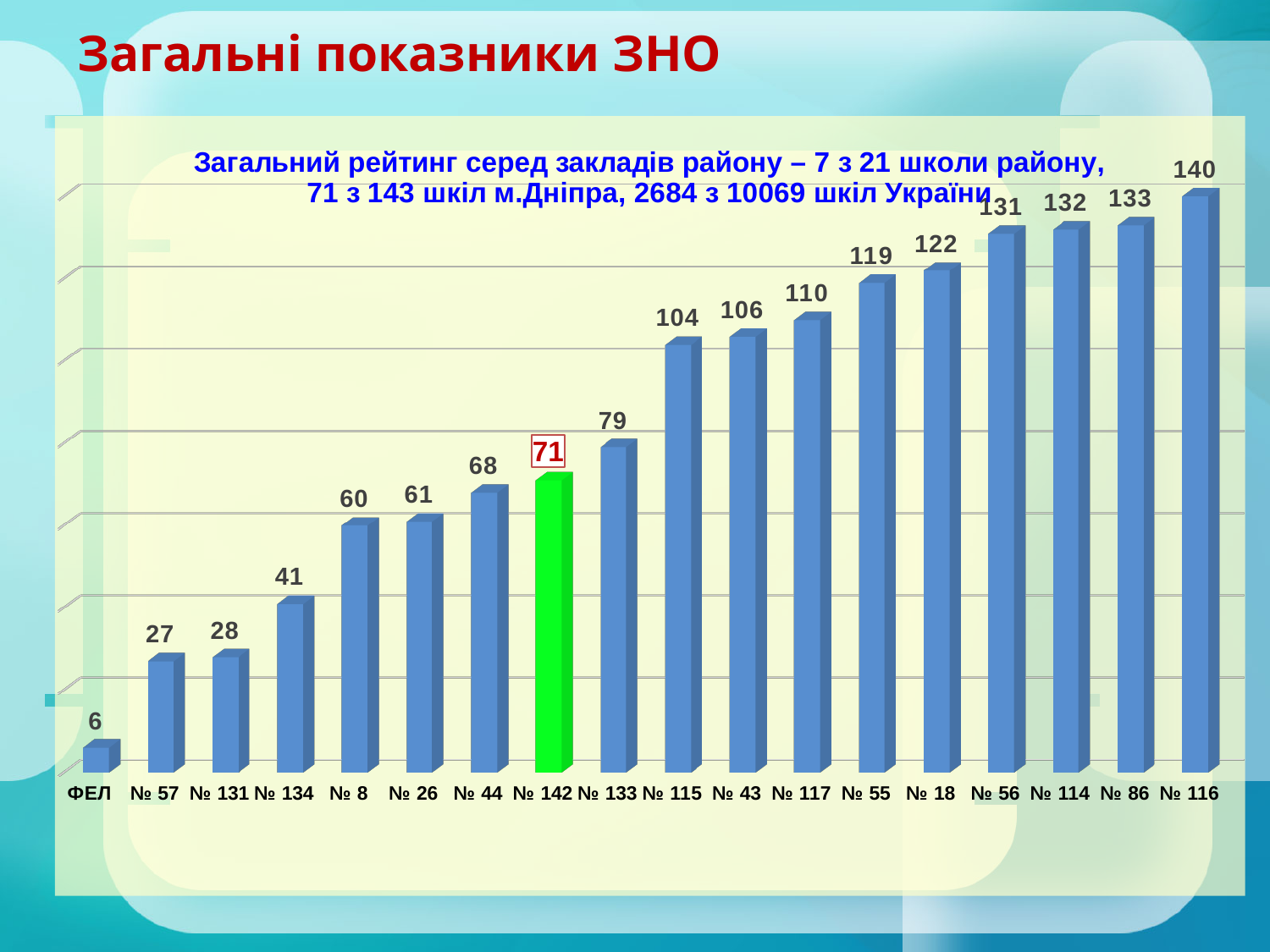
What is the value for № 115? 104 What is the value for ФЕЛ? 6 What is the value for № 18? 122 What is the difference between the values for № 134 and № 131? 13 What is the value for № 142, the green bar? 71 What is the difference between the values for № 116 and № 142? 69 Which category has the lowest value? ФЕЛ Which category has the highest value? № 116 Which is larger, the value for № 133 or the value for № 44? № 133 What kind of chart is shown on the slide? bar chart How many categories are shown on the x axis? 18 Do the values rise or fall from left to right along the x axis? rise